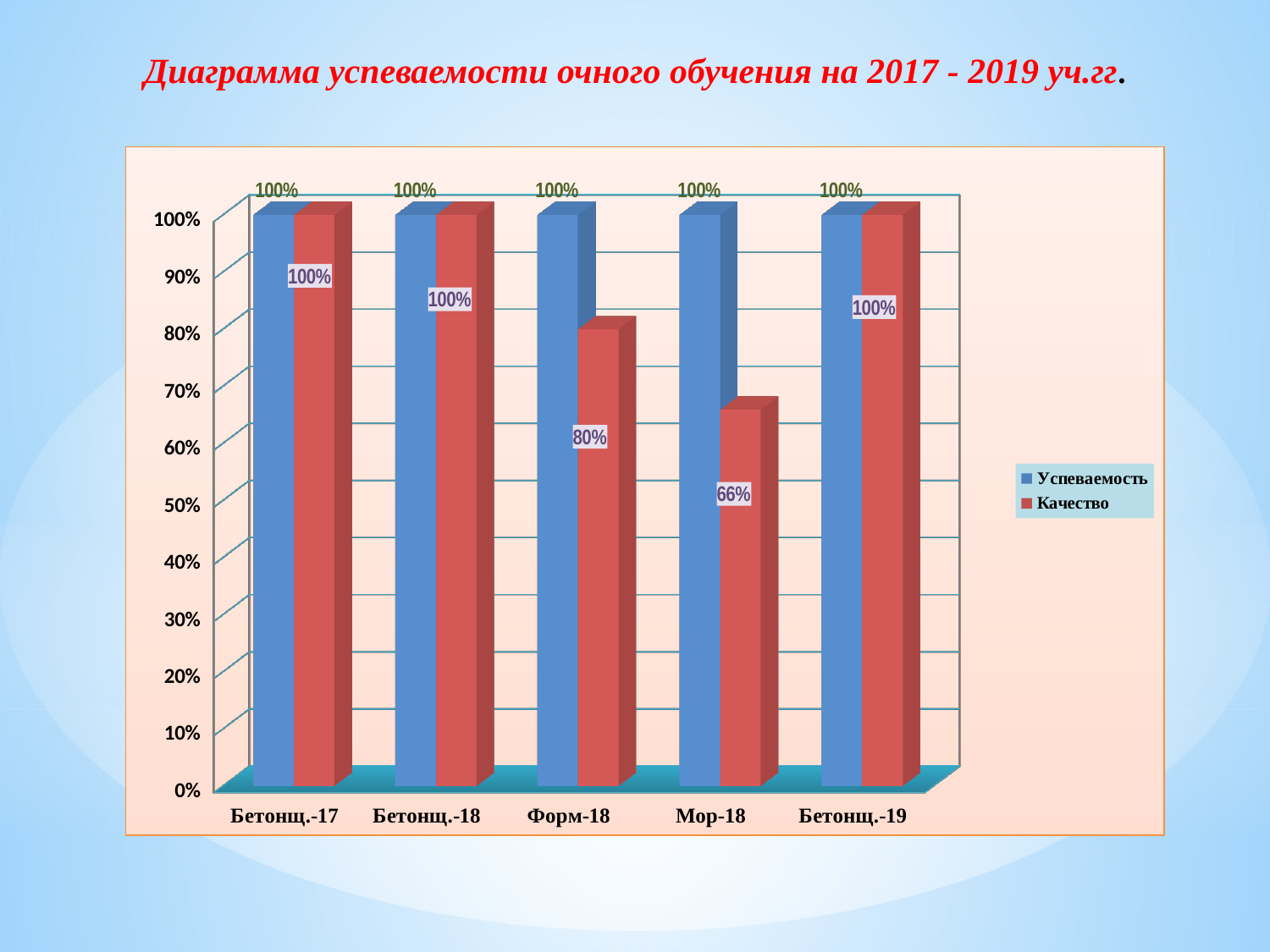
How many categories are shown on the x axis? 5 What is the difference between the Успеваемость and Качество values for Мор-18? 34% What is the Качество value for Бетонщ.-19? 100% What is the Успеваемость value for Бетонщ.-18? 100% Which is larger for Форм-18, Успеваемость or Качество? Успеваемость Which category has the lowest Качество value? Мор-18 Which series is shown in red in the legend? Качество What kind of chart is shown on the slide? Bar chart What is the difference between the Качество values for Форм-18 and Мор-18? 14% What is the Качество value for Мор-18? 66% How many series does the legend list? 2 What is the Качество value for Форм-18? 80%